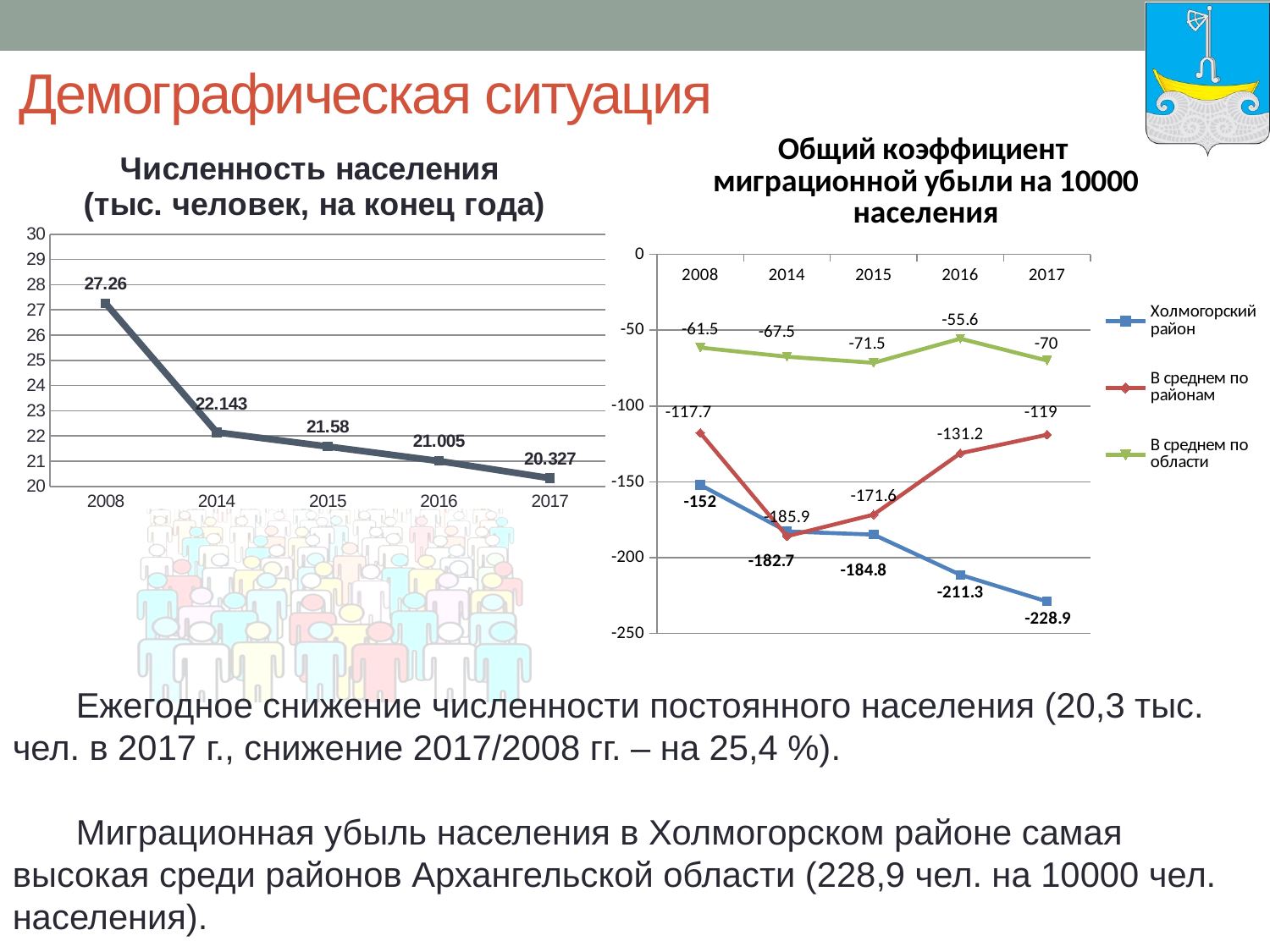
In the chart 'Общий коэффициент миграционной убыли на 10000 населения', which series is shown in green? В среднем по области In the chart 'Общий коэффициент миграционной убыли на 10000 населения', which is larger in 2017: the value for Холмогорский район or the value for 'В среднем по районам'? В среднем по районам In the chart 'Общий коэффициент миграционной убыли на 10000 населения', what is the value for 'В среднем по области' in 2016? -55.6 In the chart 'Численность населения (тыс. человек, на конец года)', what is the value for 2008? 27.26 In the chart 'Численность населения (тыс. человек, на конец года)', how many years are plotted? 5 In the chart 'Численность населения (тыс. человек, на конец года)', which year has the lowest value? 2017 What type of chart is 'Численность населения (тыс. человек, на конец года)'? line chart In the chart 'Численность населения (тыс. человек, на конец года)', what is the value for 2017? 20.327 In the chart 'Общий коэффициент миграционной убыли на 10000 населения', how many series does the legend list? 3 In the chart 'Общий коэффициент миграционной убыли на 10000 населения', what is the value for Холмогорский район in 2017? -228.9 In the chart 'Численность населения (тыс. человек, на конец года)', do the values rise or fall from 2008 to 2017? fall In the chart 'Общий коэффициент миграционной убыли на 10000 населения', what is the difference between the 2008 and 2017 values for Холмогорский район? 76.9